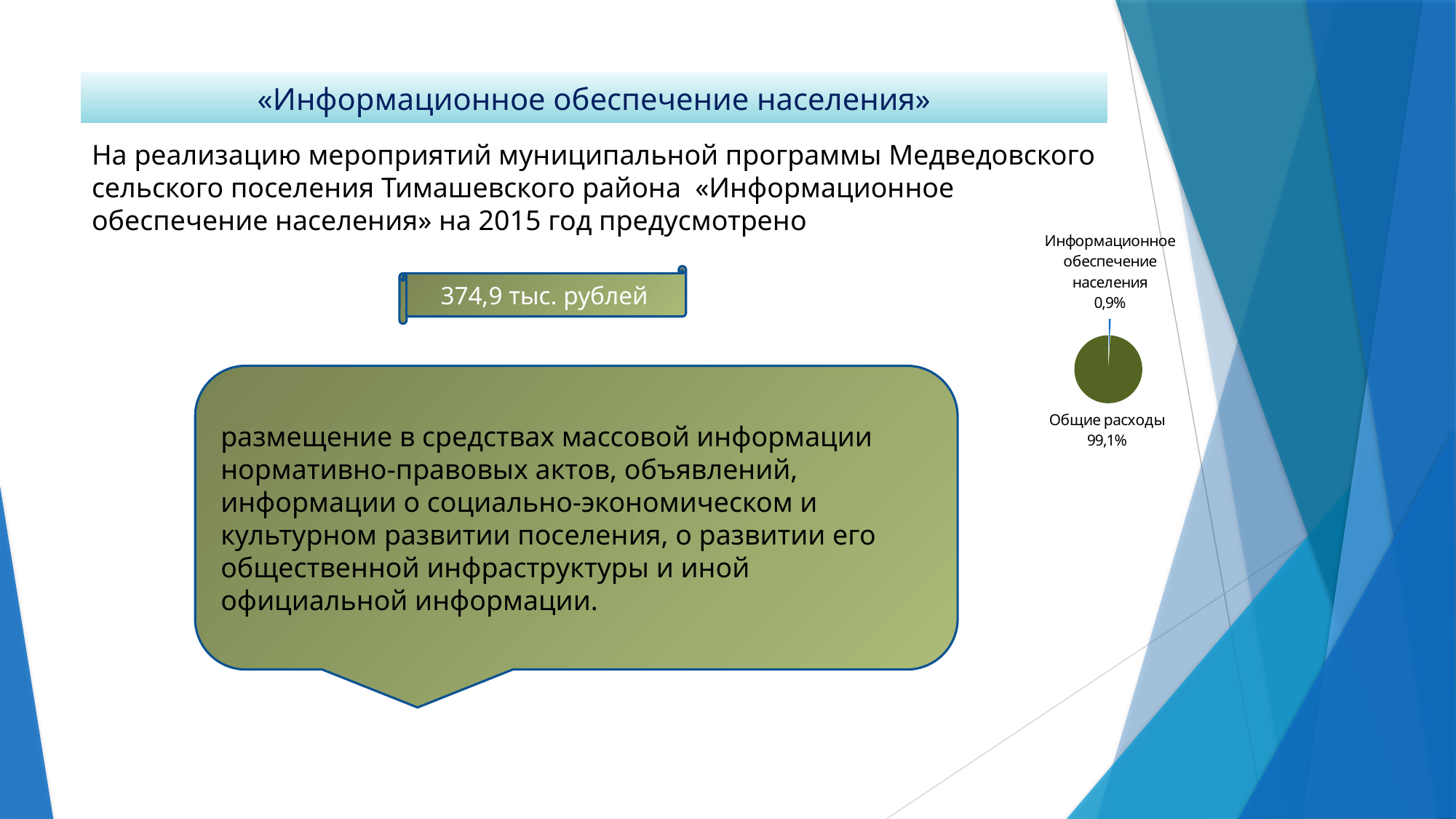
What share of the pie chart is labelled "Общие расходы"? 99,1% Which slice of the pie chart is the smallest? Информационное обеспечение населения Which slice of the pie chart is the largest? Общие расходы What share of the pie chart is labelled "Информационное обеспечение населения"? 0,9% What is the difference between the shares of "Общие расходы" and "Информационное обеспечение населения" in the pie chart? 98,2% How many slices does the pie chart have? 2 What is the total of the two shares shown in the pie chart? 100% Which is larger in the pie chart: "Общие расходы" or "Информационное обеспечение населения"? Общие расходы Is the share for "Информационное обеспечение населения" in the pie chart greater or less than 50%? less What kind of chart is shown on the slide? pie chart